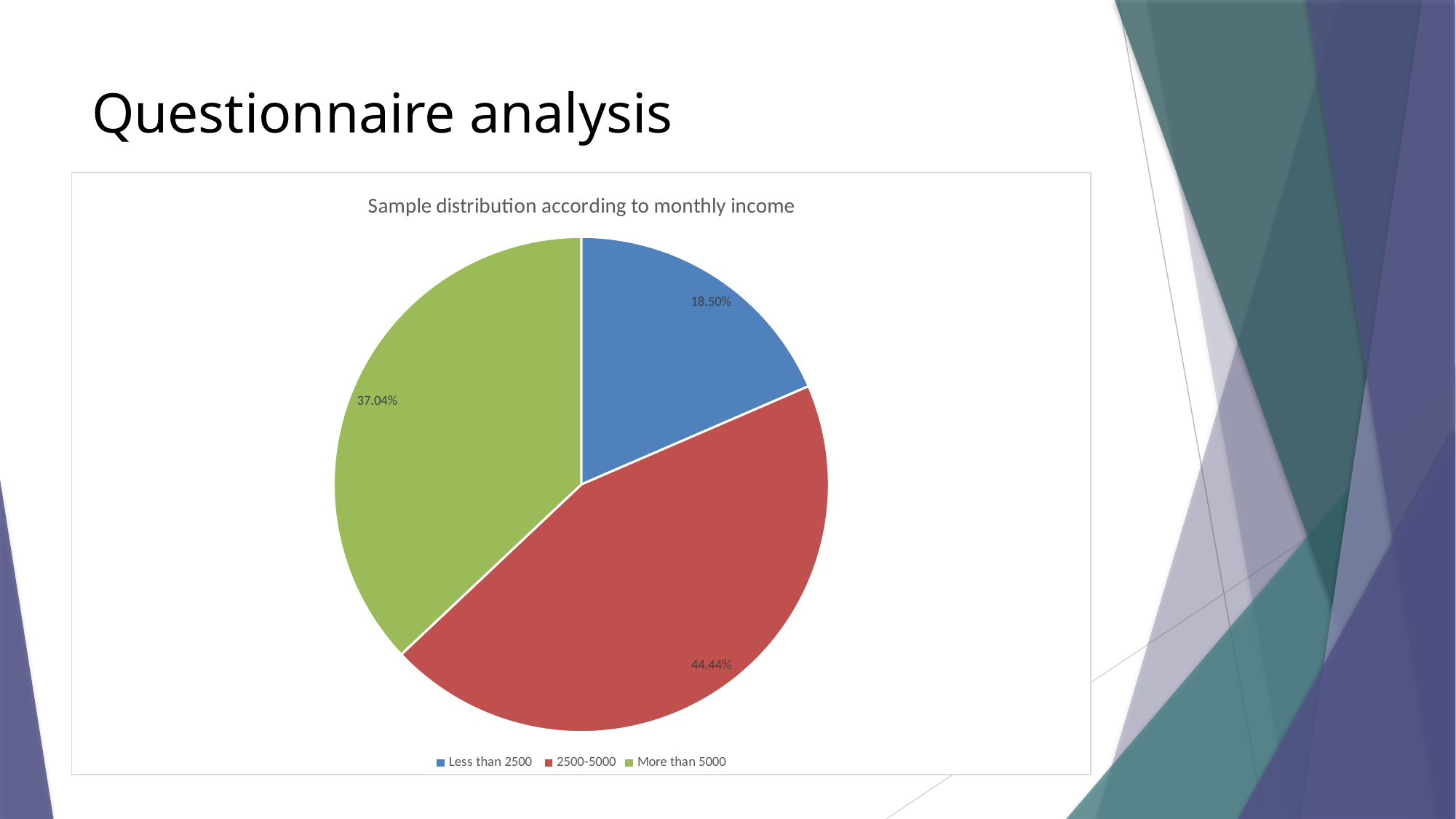
What is the difference in percentage points between the More than 5000 group and the Less than 2500 group? 18.54 Which colour represents the 2500-5000 income group? Red What percentage of the sample has a monthly income of less than 2500? 18.50% Which income group has the smallest share of the sample? Less than 2500 What is the title of the chart? Sample distribution according to monthly income What percentage of the sample has a monthly income of more than 5000? 37.04% How many income categories are shown in the pie chart? 3 Which income group has the largest share of the sample? 2500-5000 What percentage of the sample has a monthly income of 2500-5000? 44.44% What is the difference in percentage points between the 2500-5000 group and the More than 5000 group? 7.40 Which is larger: the share for Less than 2500 or the share for More than 5000? More than 5000 What kind of chart is shown on the slide? Pie chart